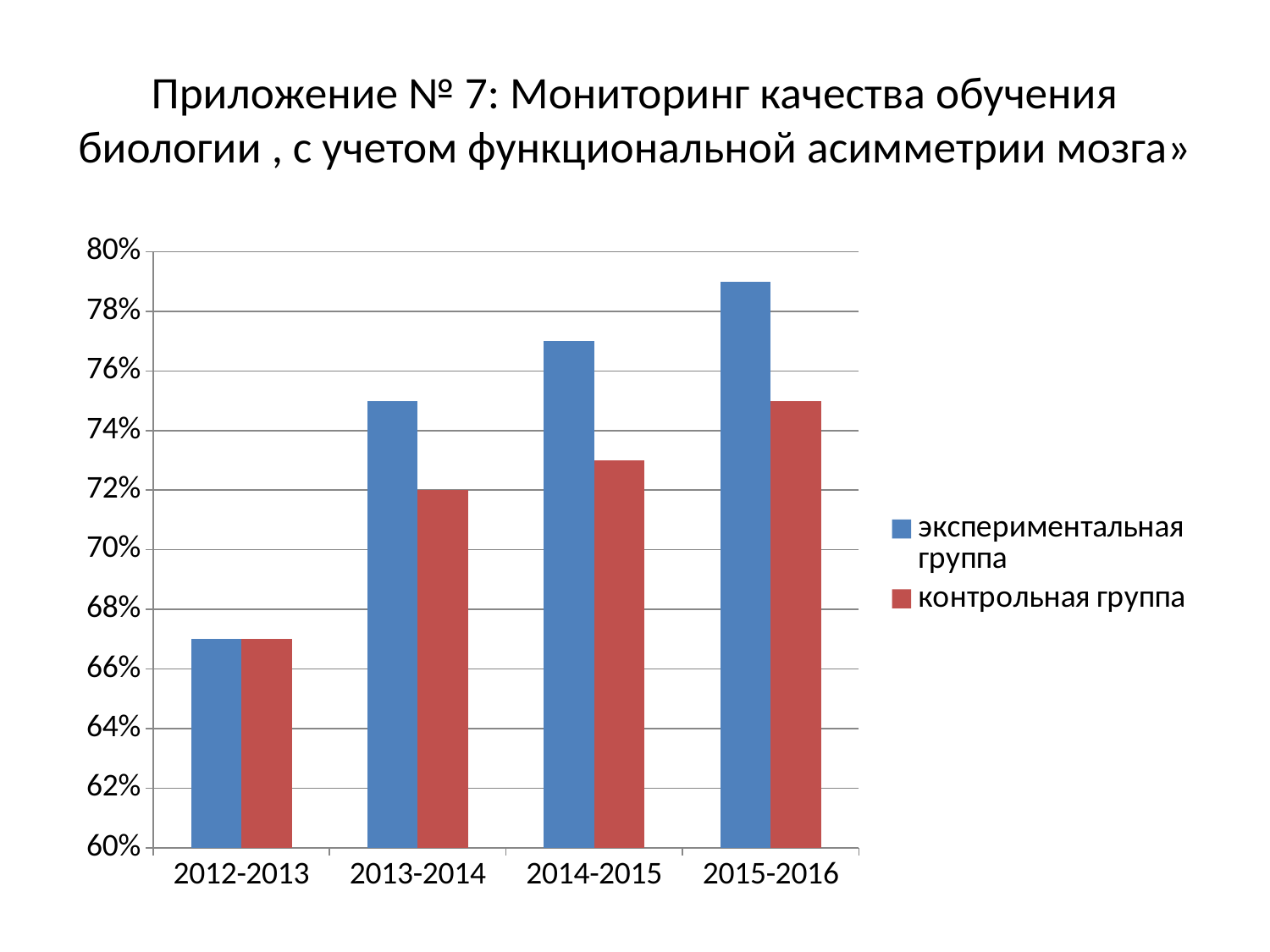
In which year is the value for экспериментальная группа highest? 2015-2016 Do the values for экспериментальная группа rise or fall from 2012-2013 to 2015-2016? rise Is the value for экспериментальная группа in 2015-2016 greater or less than 78%? greater Is the value for экспериментальная группа in 2012-2013 greater or less than 68%? less What kind of chart is shown on the slide? bar chart In which year is the value for контрольная группа lowest? 2012-2013 How many series does the legend list? 2 How many academic-year categories are shown on the x axis? 4 Which is larger in 2014-2015: экспериментальная группа or контрольная группа? экспериментальная группа What is the value for контрольная группа in 2013-2014? 72% Is the value for контрольная группа in 2014-2015 greater or less than 74%? less Which colour represents контрольная группа in the chart? red